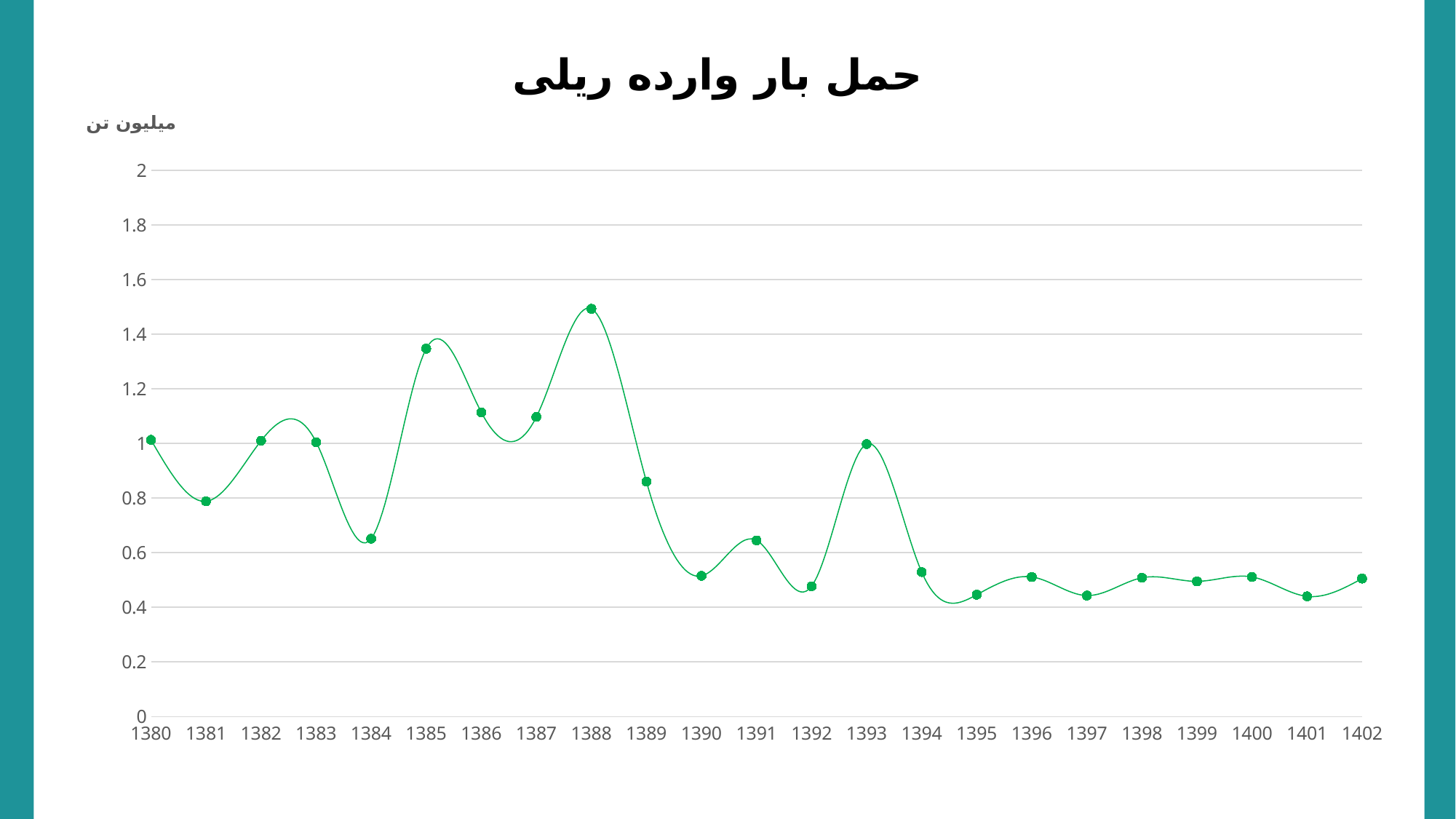
Which is larger, the value for 1388 or the value for 1385? 1388 Do the values rise or fall from 1388 to 1390? fall What kind of chart is shown on the slide? line chart What is the title of the chart? حمل بار وارده ریلی Is the value for 1389 greater or less than 0.8? greater Is the value for 1388 greater or less than 1.4? greater Is the value for 1386 greater or less than 1? greater Which is larger, the value for 1380 or the value for 1381? 1380 What unit is shown above the vertical axis? میلیون تن Which year has the highest value? 1388 How many years are plotted along the x axis? 23